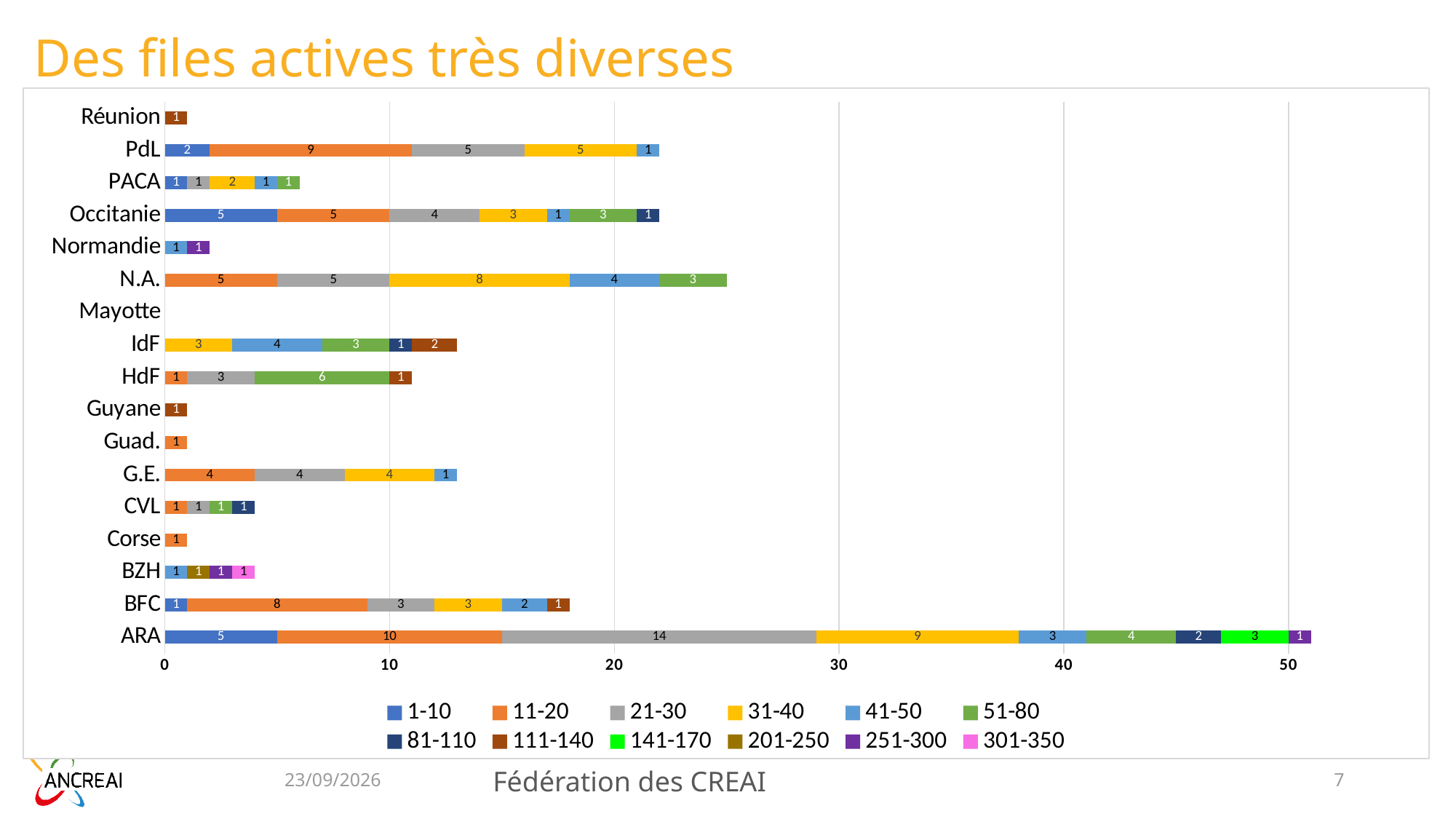
What is the value of the 51-80 segment for HdF? 6 What is the value of the 31-40 segment for N.A.? 8 What kind of chart is shown on the slide? Stacked bar chart What is the difference between the 11-20 value for ARA and the 11-20 value for PdL? 1 Which has a larger 11-20 value, PdL or Occitanie? PdL What is the title of the slide containing the chart? Des files actives très diverses What is the total of the stacked bar for ARA? 51 What is the total of the stacked bar for N.A.? 25 What is the value of the 21-30 segment for ARA? 14 Which region has the longest stacked bar overall? ARA How many regions (categories) are listed on the vertical axis? 17 How many series does the legend list? 12